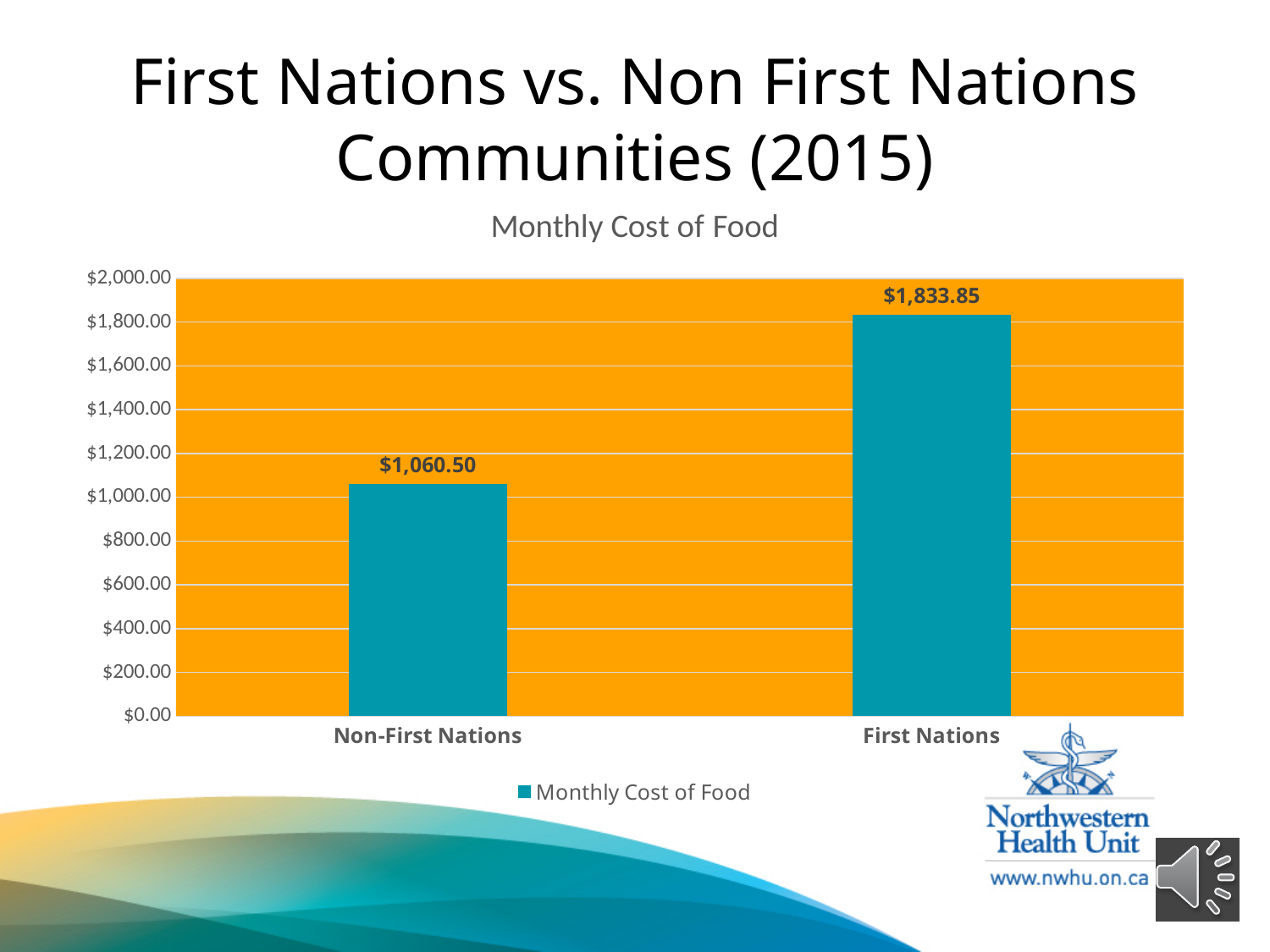
Which category has the lower monthly cost of food? Non-First Nations What is the monthly cost of food for Non-First Nations communities? $1,060.50 Is the monthly cost of food higher for First Nations or Non-First Nations communities? First Nations Is the value for First Nations greater or less than $1,600.00? greater How many series does the legend list? 1 What kind of chart is shown on the slide? bar chart What is the title of the chart? Monthly Cost of Food What is the monthly cost of food for First Nations communities? $1,833.85 What is the difference in monthly cost of food between First Nations and Non-First Nations communities? $773.35 Is the value for Non-First Nations greater or less than $1,200.00? less Which category has the higher monthly cost of food? First Nations How many categories are shown on the x axis? 2